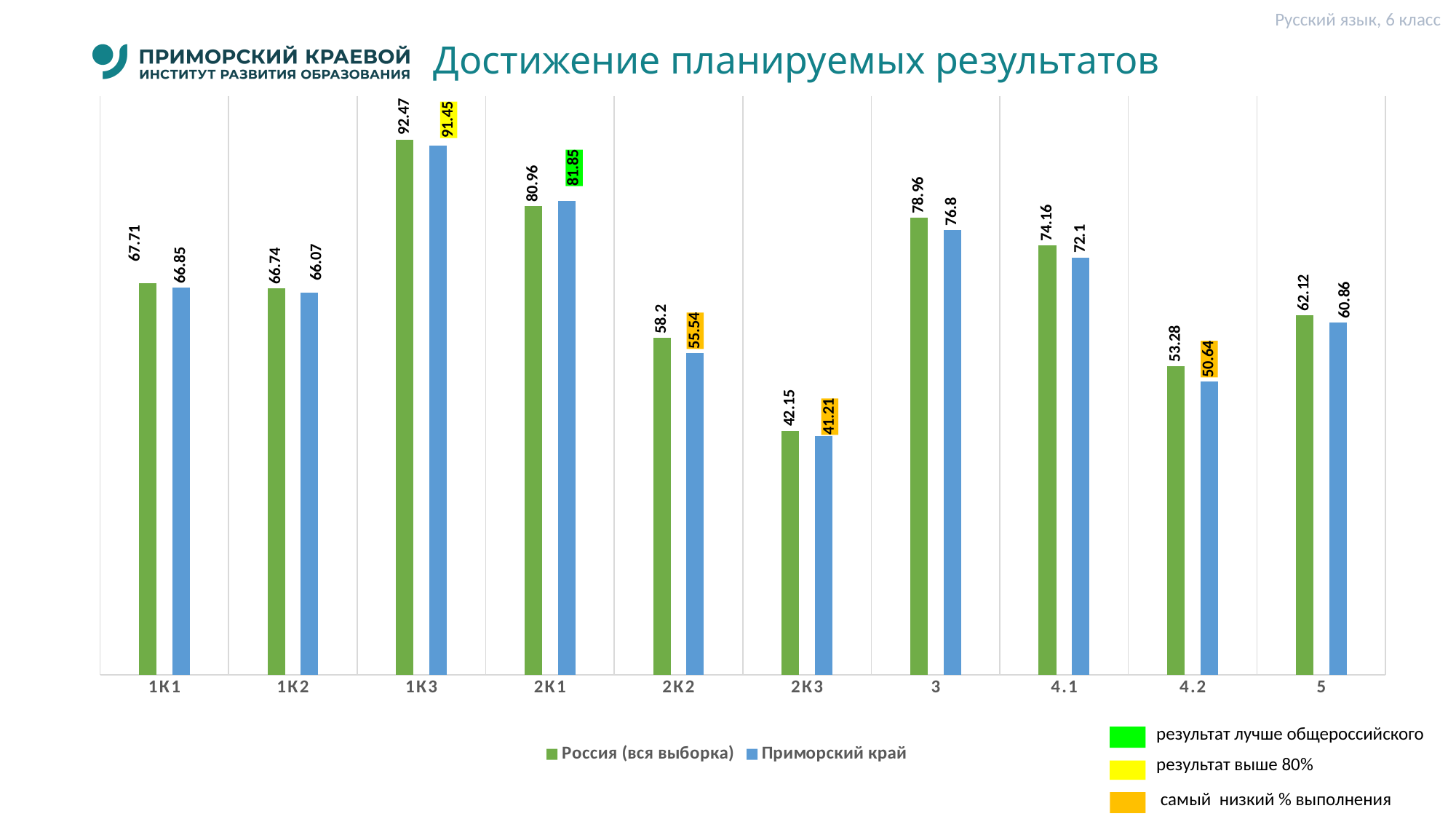
What is the title of the chart? Достижение планируемых результатов Which category has the highest value for Россия (вся выборка)? 1К3 What is the value for Приморский край in category 1К3? 91.45 How many categories are shown on the x axis? 10 In category 2К1, which series has the larger value: Россия (вся выборка) or Приморский край? Приморский край What is the value for Приморский край in category 4.2? 50.64 In category 3, which series has the larger value: Россия (вся выборка) or Приморский край? Россия (вся выборка) What kind of chart is shown on the slide? Bar chart Which category has the lowest value for Приморский край? 2К3 How many series does the chart legend list? 2 What is the value for Россия (вся выборка) in category 2К1? 80.96 What is the difference between Россия (вся выборка) and Приморский край in category 2К2? 2.66